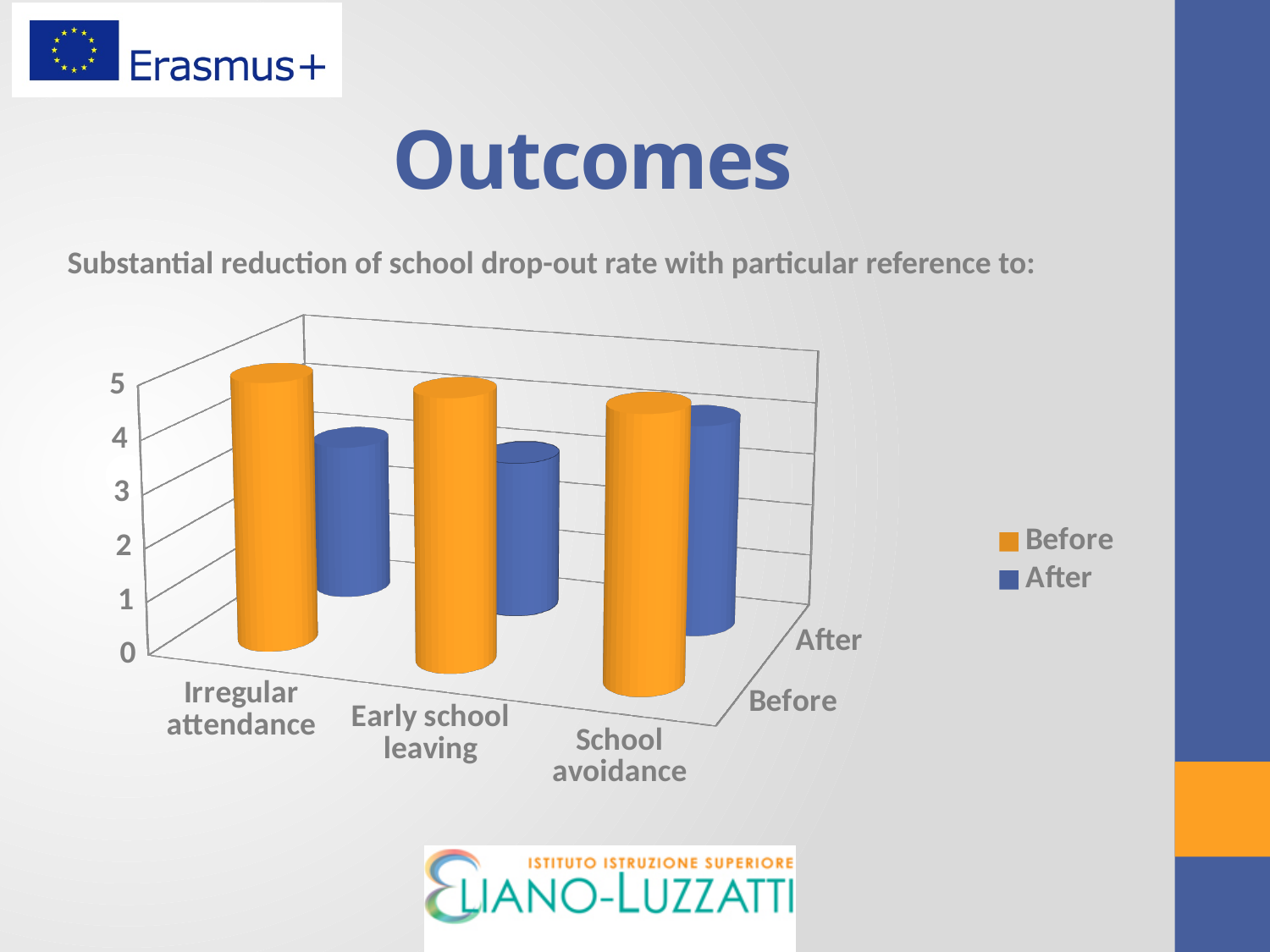
Is the After value for Irregular attendance greater or less than 5? less Is the After value for Early school leaving greater or less than 1? greater What are the two entries listed in the chart legend? Before and After What colour represents the Before series in the chart? orange How many categories are shown on the x axis of the chart? 3 Which series is larger for School avoidance, Before or After? Before What kind of chart is shown on the slide? bar chart Is the Before value for School avoidance greater or less than 2? greater Which series is larger for Early school leaving, Before or After? Before Which series is larger for Irregular attendance, Before or After? Before How many series does the chart legend list? 2